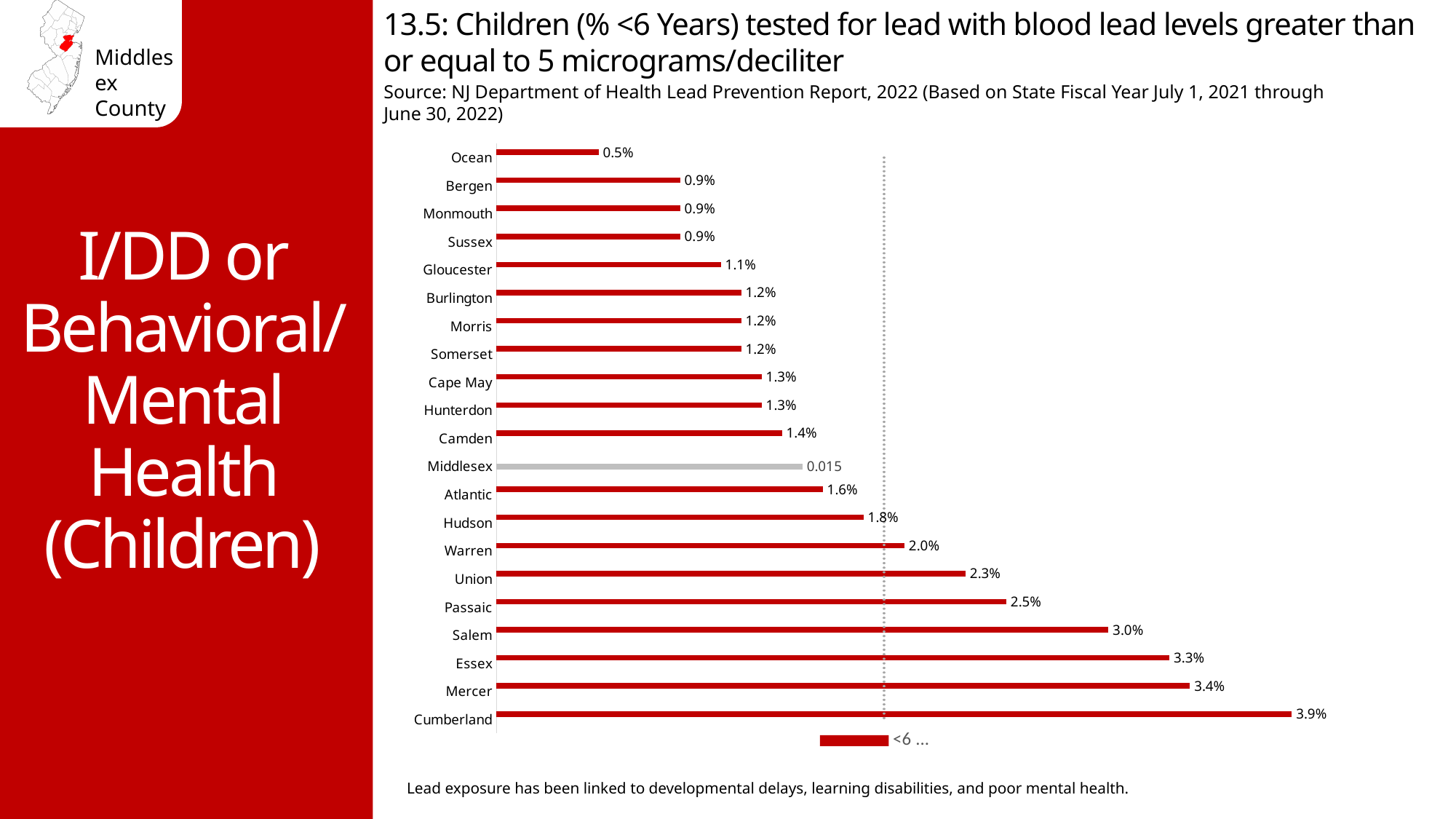
Which county's bar is coloured grey instead of red? Middlesex What kind of chart is shown on the slide? Bar chart What is the value for Cumberland? 3.9% Which county has the lowest value? Ocean What is the value for Essex? 3.3% How many counties are shown in the chart? 21 What is the difference between the values for Salem and Passaic? 0.5% Which county has the highest value? Cumberland What is the value for Ocean? 0.5% What is the difference between the values for Cumberland and Ocean? 3.4% What is the value shown for Middlesex? 0.015 Which has a larger value, Mercer or Essex? Mercer